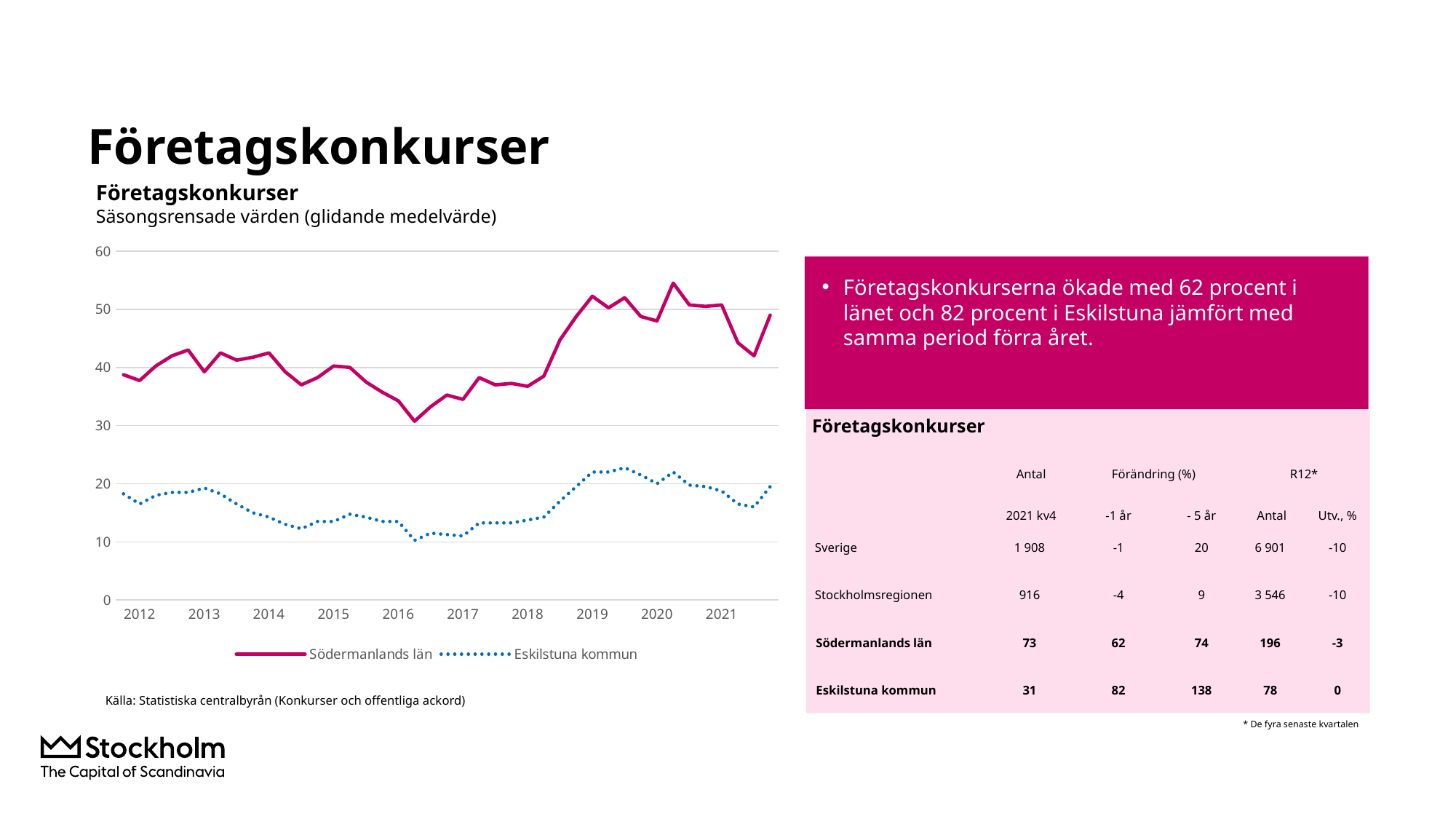
How many series does the chart legend list? 2 Does the Eskilstuna kommun line rise or fall between 2013 and 2016? fall Which two series are listed in the chart legend? Södermanlands län and Eskilstuna kommun Does the Södermanlands län line rise or fall between 2016 and 2019? rise How many year labels are shown on the x axis of the chart? 10 Which series has higher values throughout the chart, Södermanlands län or Eskilstuna kommun? Södermanlands län What kind of chart is shown on the slide? line chart Is the value for Södermanlands län around 2016 greater or less than 40? less Is the highest value for Södermanlands län, reached around 2020, greater or less than 50? greater What is the subtitle shown under the chart title 'Företagskonkurser'? Säsongsrensade värden (glidande medelvärde) Is the value for Södermanlands län at the start of 2012 greater or less than 30? greater